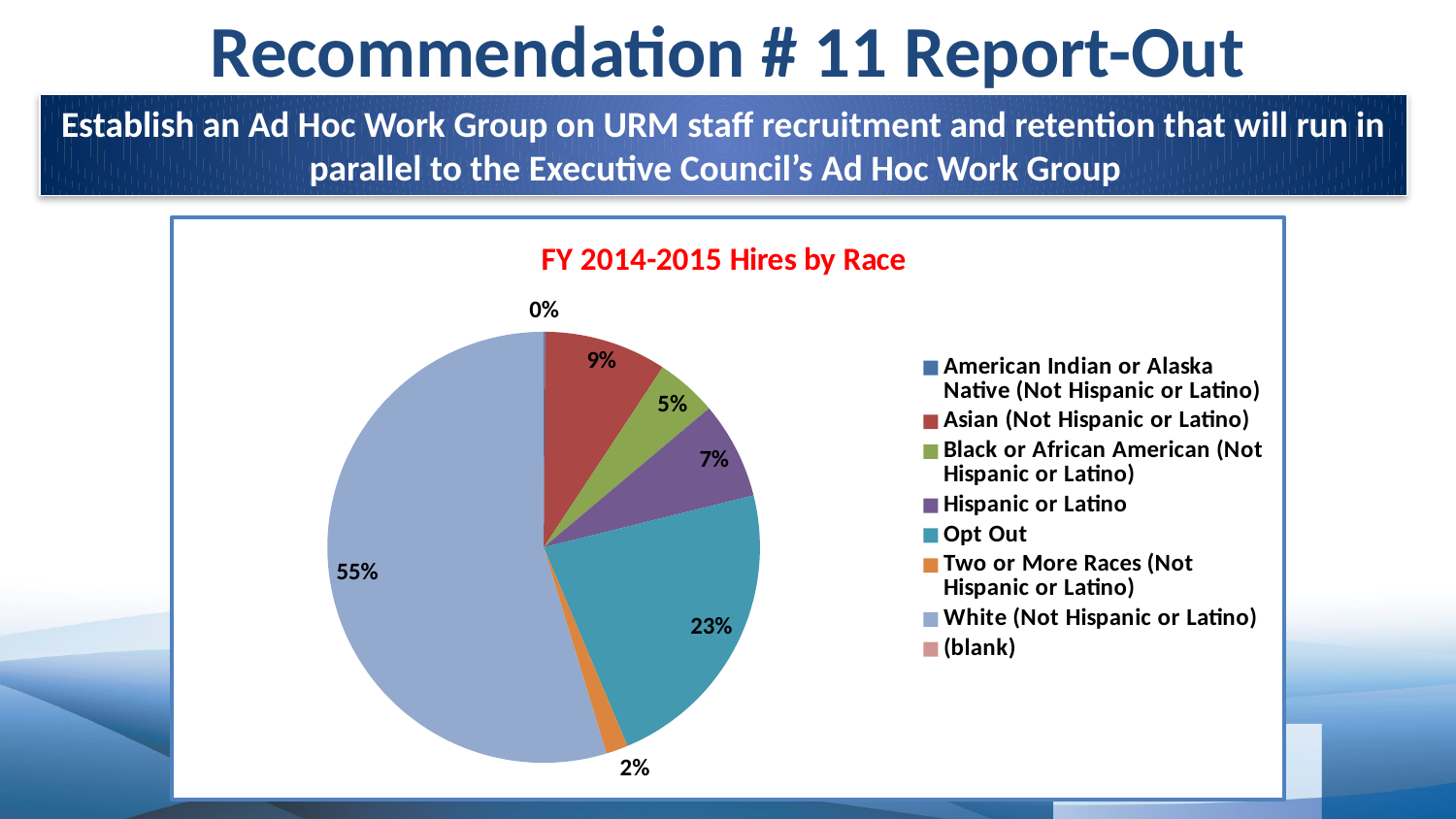
Which category has the largest share of FY 2014-2015 hires? White (Not Hispanic or Latino) What share of FY 2014-2015 hires is White (Not Hispanic or Latino)? 55% What share of FY 2014-2015 hires is Hispanic or Latino? 7% How many entries does the legend of the pie chart list? 8 What share of FY 2014-2015 hires is Opt Out? 23% Which is larger, the share for Asian (Not Hispanic or Latino) or the share for Hispanic or Latino? Asian (Not Hispanic or Latino) What kind of chart is shown on the slide? pie chart What is the title of the pie chart? FY 2014-2015 Hires by Race What is the difference in percentage points between the White (Not Hispanic or Latino) share and the Opt Out share? 32 percentage points